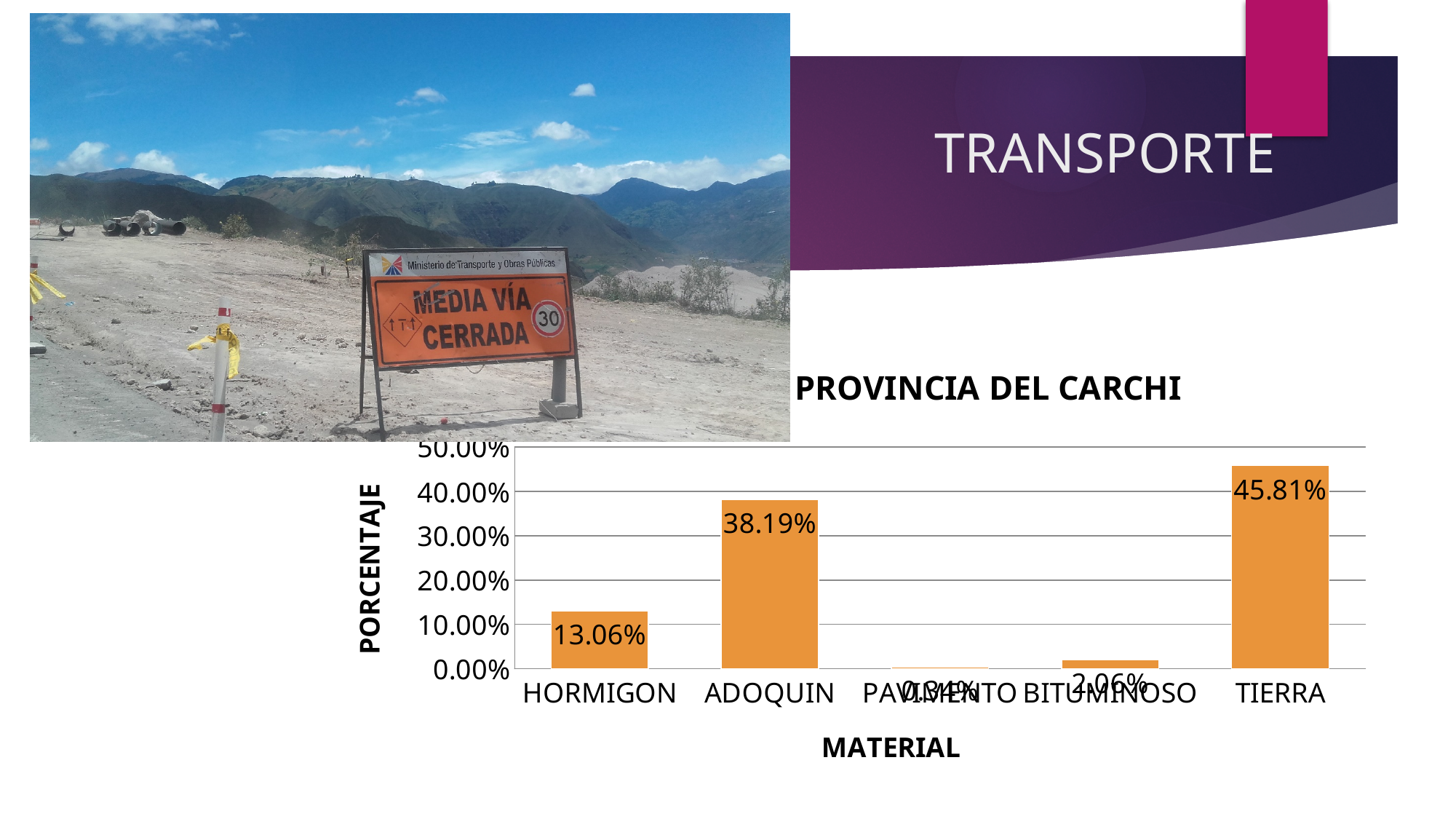
Which material has the lowest percentage in the PROVINCIA DEL CARCHI chart? PAVIMENTO How many materials are shown in the PROVINCIA DEL CARCHI chart? 5 Is the value for BITUMINOSO in the PROVINCIA DEL CARCHI chart greater or less than 10.00%? less What is the difference between the values for TIERRA and ADOQUIN in the PROVINCIA DEL CARCHI chart? 7.62% What is the value for HORMIGON in the PROVINCIA DEL CARCHI chart? 13.06% What is the difference between the values for ADOQUIN and HORMIGON in the PROVINCIA DEL CARCHI chart? 25.13% Which material has the highest percentage in the PROVINCIA DEL CARCHI chart? TIERRA What is the value for ADOQUIN in the PROVINCIA DEL CARCHI chart? 38.19% Which is larger in the PROVINCIA DEL CARCHI chart, the value for HORMIGON or the value for ADOQUIN? ADOQUIN What kind of chart is the PROVINCIA DEL CARCHI chart? bar chart What is the title of the vertical axis in the PROVINCIA DEL CARCHI chart? PORCENTAJE What is the value for TIERRA in the PROVINCIA DEL CARCHI chart? 45.81%